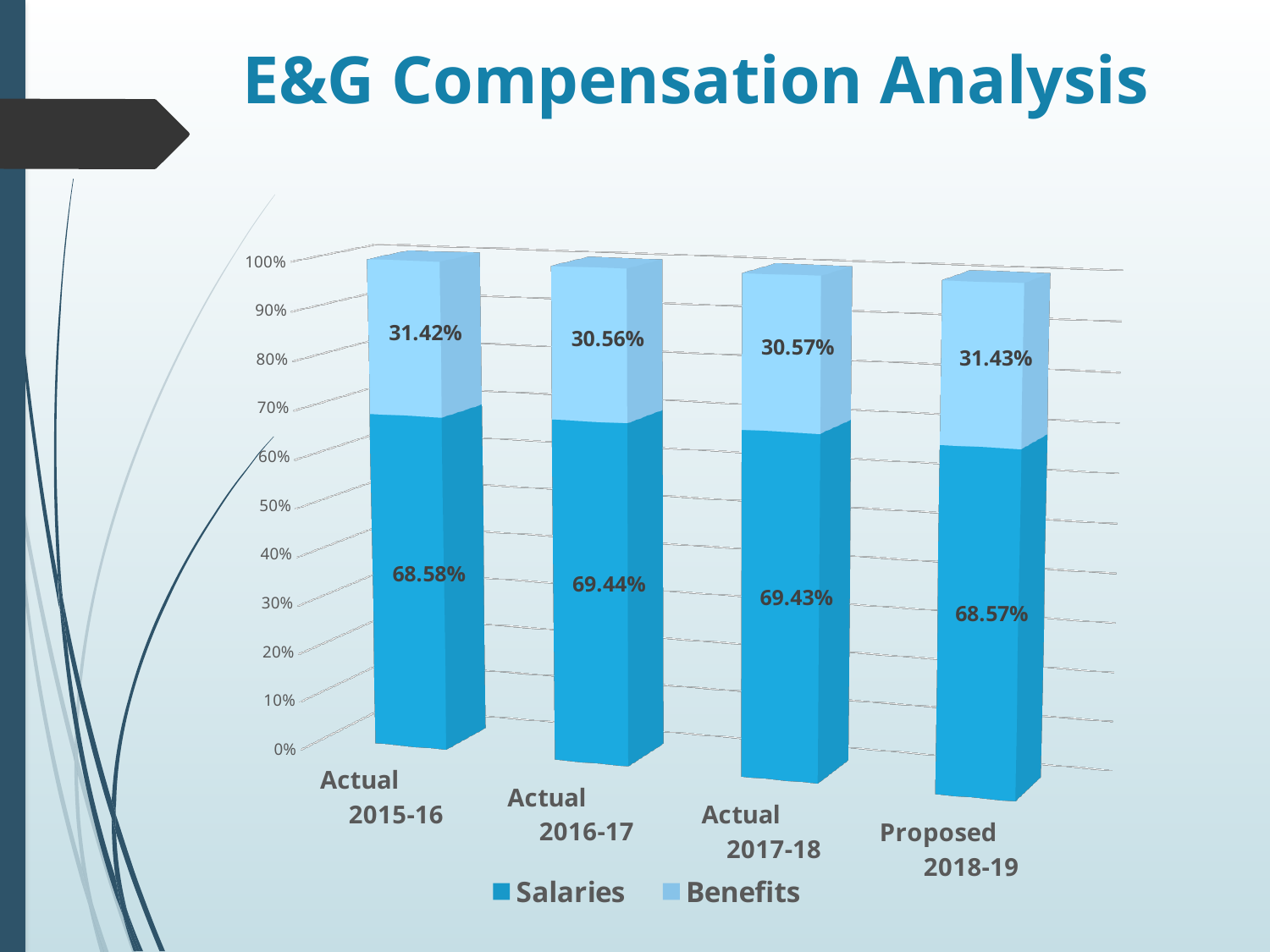
What is the Salaries value for Actual 2017-18? 69.43% What is the Salaries value for Actual 2015-16? 68.58% What is the total of the stacked bar for Proposed 2018-19? 100% How many series does the legend list? 2 What is the difference between the Salaries value for Actual 2016-17 and Actual 2015-16? 0.86 percentage points What is the Benefits value for Actual 2016-17? 30.56% Which is larger, the Salaries value for Actual 2015-16 or for Actual 2016-17? Actual 2016-17 How many categories are shown on the x axis? 4 What is the Benefits value for Proposed 2018-19? 31.43% Is the Salaries value for Proposed 2018-19 greater or less than 60%? greater What is the title of the chart? E&G Compensation Analysis What type of chart is shown on the slide? Stacked bar chart